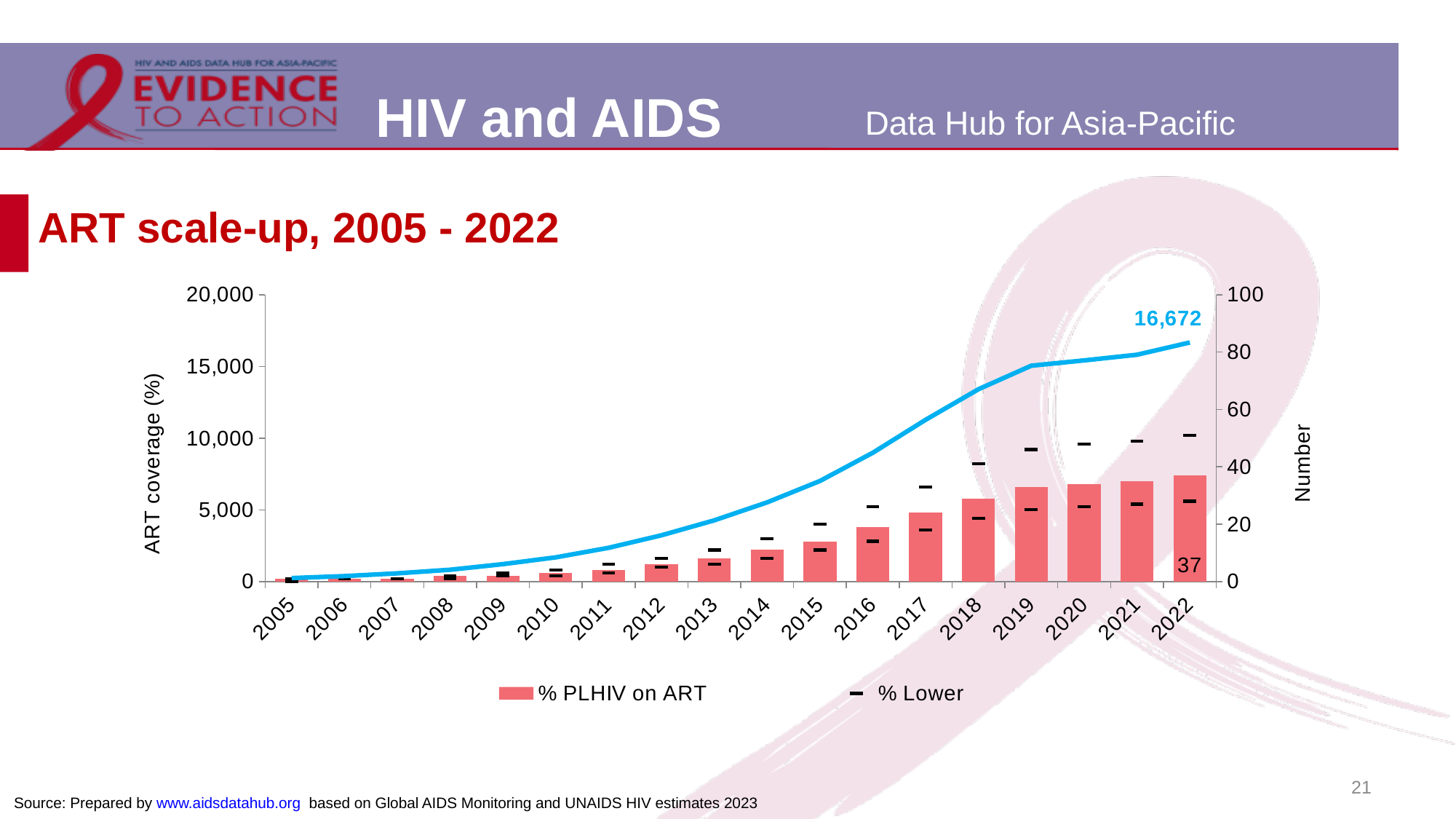
What is the value labelled on the % PLHIV on ART bar for 2022? 37 Do the % PLHIV on ART bars rise or fall from 2005 to 2022? rise Is the blue line value for 2015 greater or less than 10,000 on the left axis? less Is the % PLHIV on ART bar for 2010 greater or less than 20 on the right axis? less Which year has the shortest % PLHIV on ART bar? 2005 How many series does the legend list? 2 What is the data label shown on the blue line for 2022? 16,672 How many years are shown along the x axis? 18 Is the % PLHIV on ART bar for 2019 greater or less than 20 on the right axis? greater Which year has the tallest % PLHIV on ART bar? 2022 What is the title of the chart? ART scale-up, 2005 - 2022 Which year has the larger % PLHIV on ART bar, 2014 or 2019? 2019